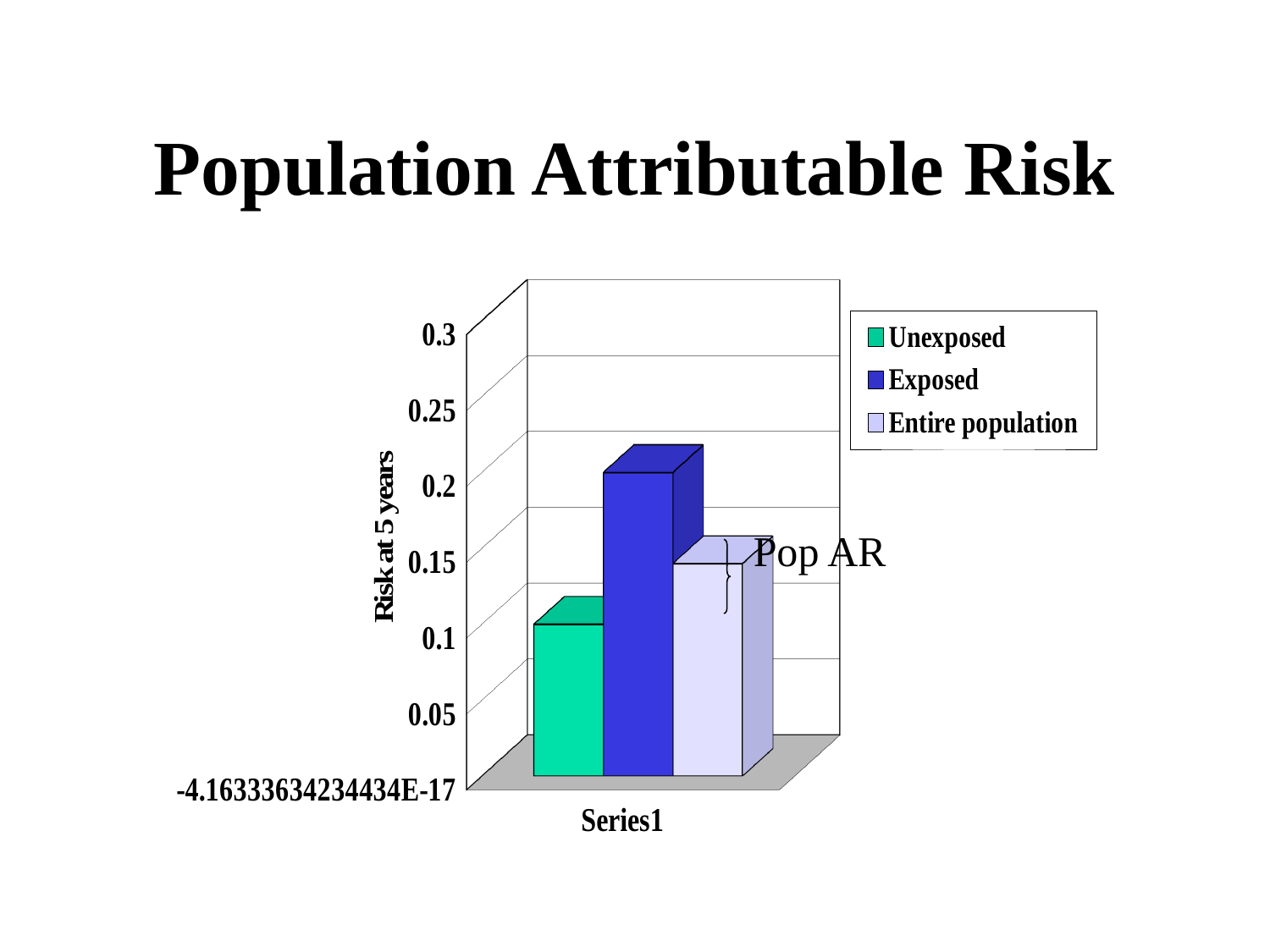
Is the value for Exposed greater or less than 0.25? less How many series does the legend list? 3 Which series has the lowest bar? Unexposed Is the value for Entire population greater or less than 0.2? less Is the value for Exposed greater or less than 0.15? greater What label appears on the horizontal axis beneath the bars? Series1 Which is larger, the bar for Exposed or the bar for Entire population? Exposed Which series has the highest bar? Exposed What is the title of the vertical axis? Risk at 5 years What kind of chart is shown on the slide? bar chart Which is larger, the bar for Unexposed or the bar for Entire population? Entire population